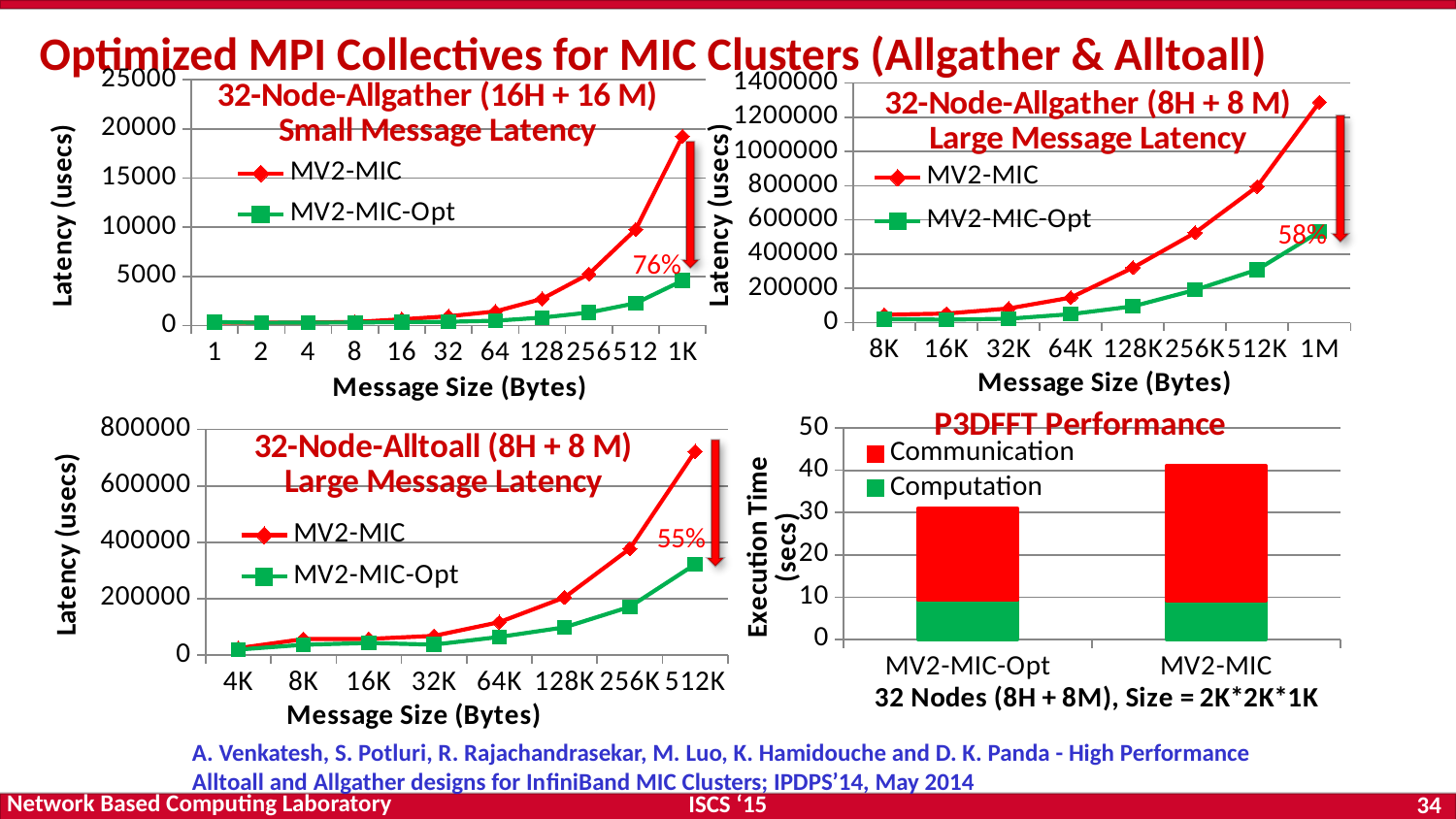
In the 32-Node-Allgather (16H + 16 M) Small Message Latency chart, is the MV2-MIC latency at 1K greater or less than 15000? greater In the P3DFFT Performance chart, is the total execution time for MV2-MIC-Opt greater or less than 40? less In the 32-Node-Alltoall (8H + 8 M) Large Message Latency chart, which series has the higher latency at 512K? MV2-MIC What percentage improvement is annotated on the 32-Node-Allgather (8H + 8 M) Large Message Latency chart? 58% What kind of chart is the P3DFFT Performance chart? bar chart In the P3DFFT Performance chart, which configuration has the higher total execution time? MV2-MIC In the 32-Node-Allgather (16H + 16 M) Small Message Latency chart, how many series does the legend list? 2 In the 32-Node-Allgather (8H + 8 M) Large Message Latency chart, is the MV2-MIC latency at 1M greater or less than 1000000? greater In the P3DFFT Performance chart, how many series does the legend list? 2 In the 32-Node-Allgather (8H + 8 M) Large Message Latency chart, how many message sizes are plotted on the x axis? 8 In the 32-Node-Alltoall (8H + 8 M) Large Message Latency chart, does the MV2-MIC latency rise or fall as message size increases? rise In the 32-Node-Allgather (16H + 16 M) Small Message Latency chart, how many message sizes are plotted on the x axis? 11